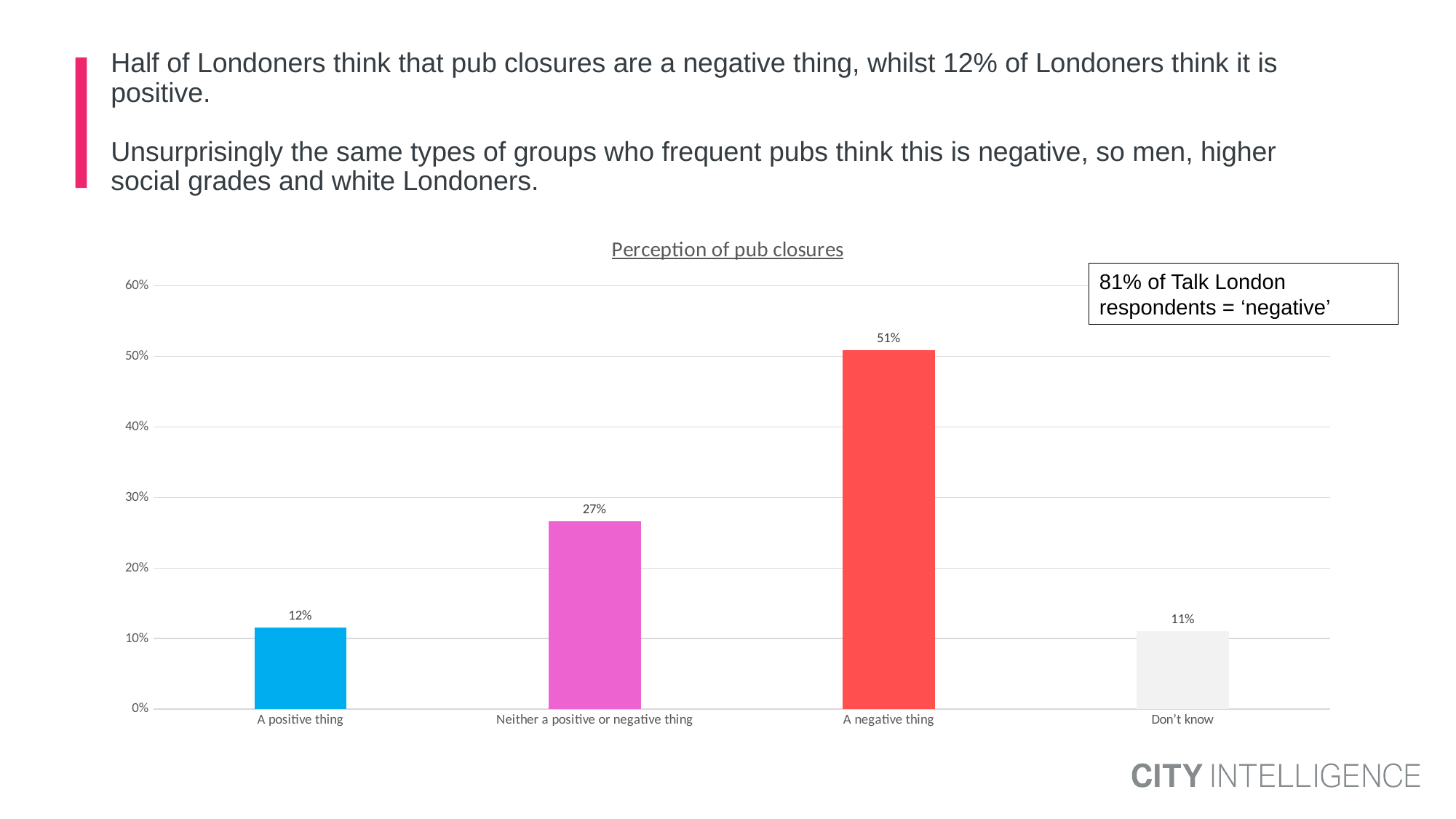
What is the value for 'Don't know'? 11% What kind of chart is shown on the slide? Bar chart What is the value for 'A negative thing'? 51% What is the value for 'Neither a positive or negative thing'? 27% What is the title of the chart? Perception of pub closures What is the value for 'A positive thing'? 12% Is the value for 'A negative thing' greater or less than 40%? greater Which is larger, 'Neither a positive or negative thing' or 'A positive thing'? Neither a positive or negative thing What is the difference between 'A negative thing' and 'A positive thing'? 39% How many categories are shown in the chart? 4 Which category has the highest value? A negative thing What is the difference between 'A negative thing' and 'Neither a positive or negative thing'? 24%